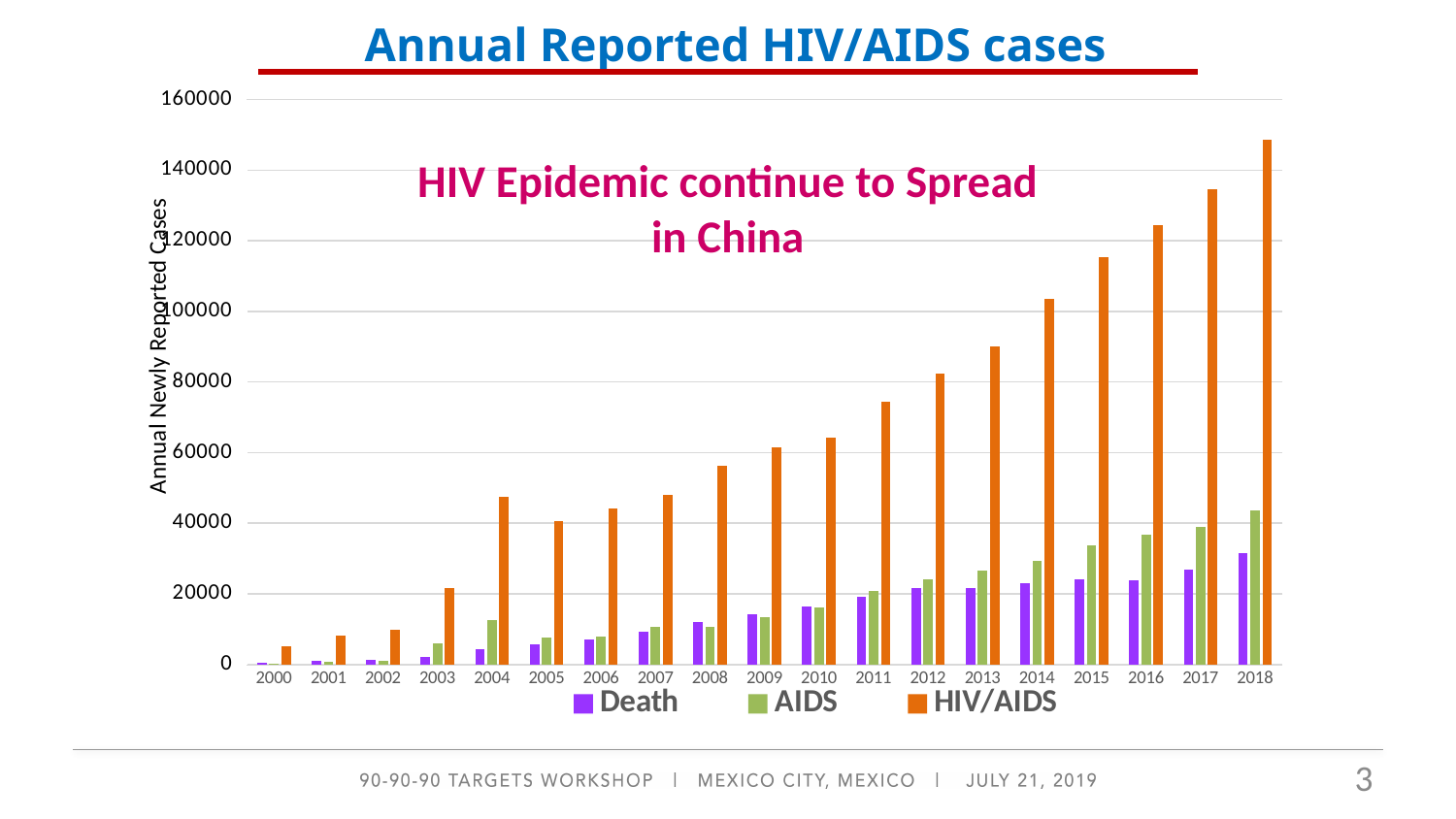
Which is larger, the HIV/AIDS value for 2016 or for 2015? 2016 What kind of chart is shown on the slide? bar chart How many years are shown on the x axis? 19 Is the AIDS value for 2018 greater or less than 40000? greater Is the HIV/AIDS value for 2011 greater or less than 80000? less How many series does the legend list? 3 Which year has the lowest HIV/AIDS value? 2000 What colour are the HIV/AIDS bars? orange Do the HIV/AIDS values generally rise or fall from 2000 to 2018? rise Is the HIV/AIDS value for 2018 greater or less than 140000? greater Which year has the highest HIV/AIDS value? 2018